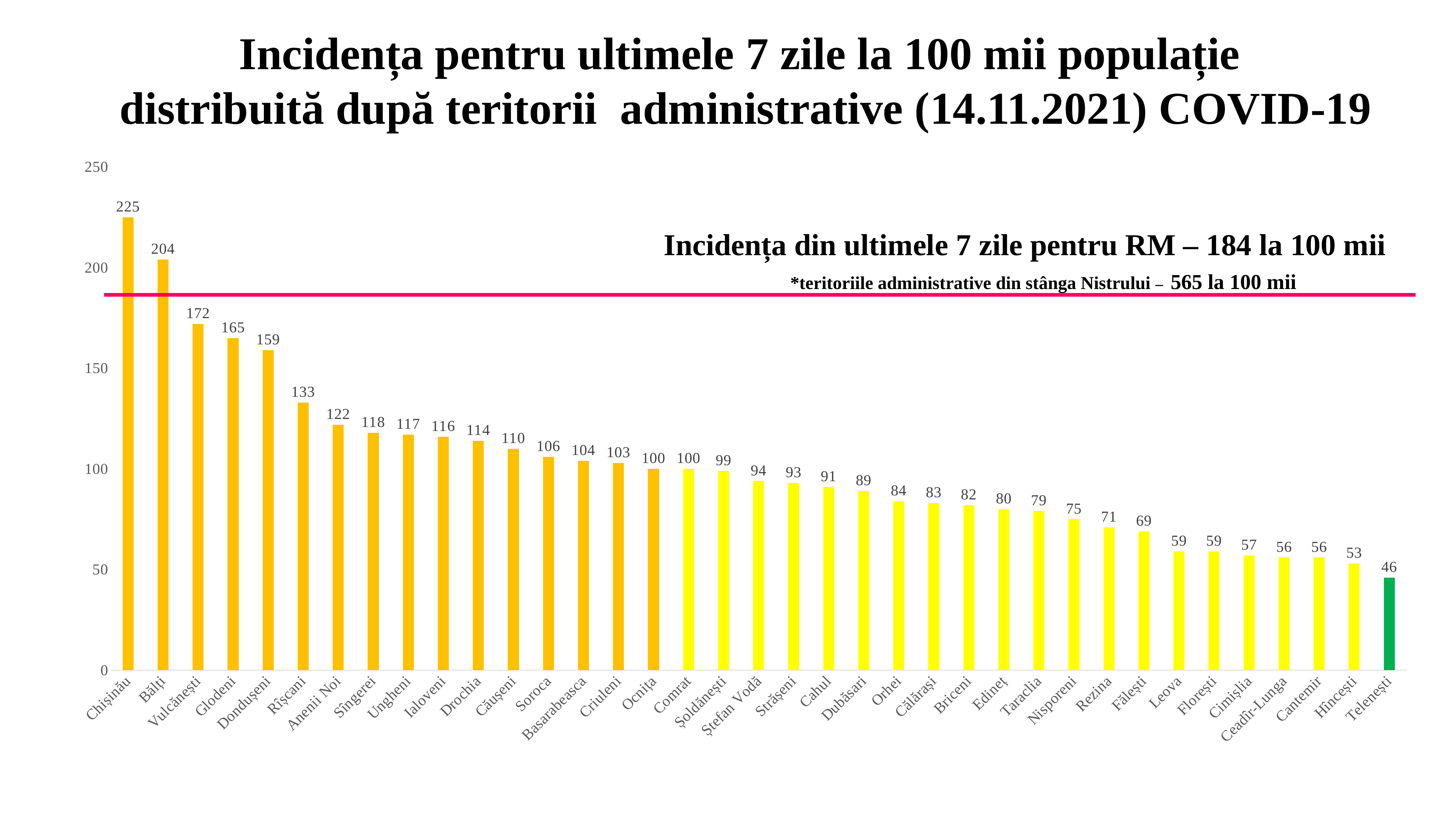
Which territory has the highest value? Chișinău Which is larger, the value for Orhei or the value for Rezina? Orhei What is the value for Glodeni? 165 What is the value for Cahul? 91 What is the value for Telenești? 46 What incidence for RM over the last 7 days is stated on the slide? 184 la 100 mii How many territories are shown on the chart? 37 Which territory has the lowest value? Telenești What is the value for Chișinău? 225 What kind of chart is shown on the slide? bar chart Do the values rise or fall from left to right along the x axis? fall What is the difference between the values for Chișinău and Bălți? 21